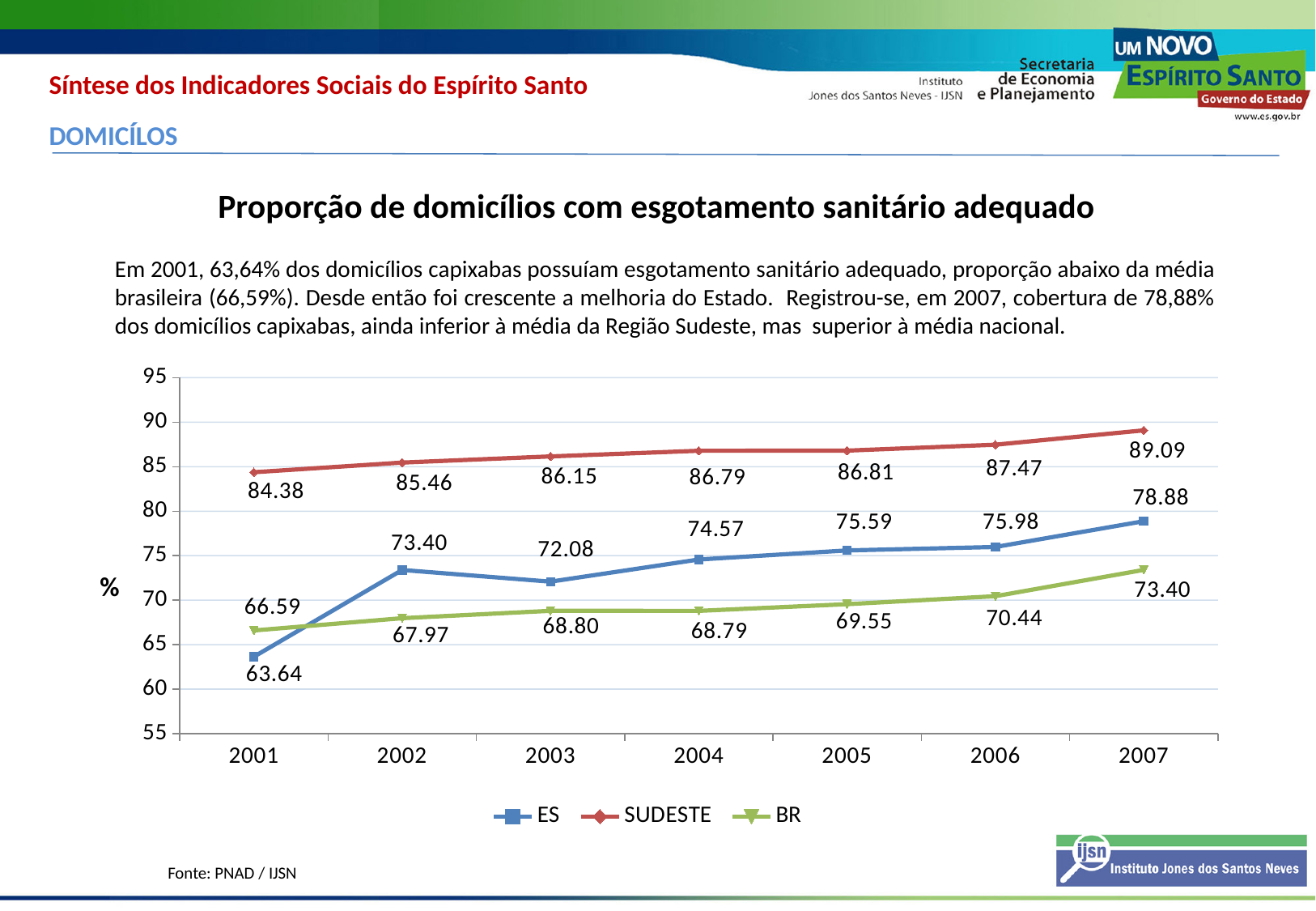
How many years are shown on the x axis? 7 What kind of chart is shown on the slide? Line chart In which year is the BR series at its lowest? 2001 What is the value for BR in 2004? 68.79 In which year is the ES series at its highest? 2007 What is the value for ES in 2001? 63.64 What is the source cited below the chart? PNAD / IJSN How many series does the legend list? 3 What is the difference between the SUDESTE and ES values in 2007? 10.21 What is the value for SUDESTE in 2007? 89.09 Which is larger in 2001, the ES value or the BR value? BR Does the SUDESTE series rise or fall from 2001 to 2007? Rise